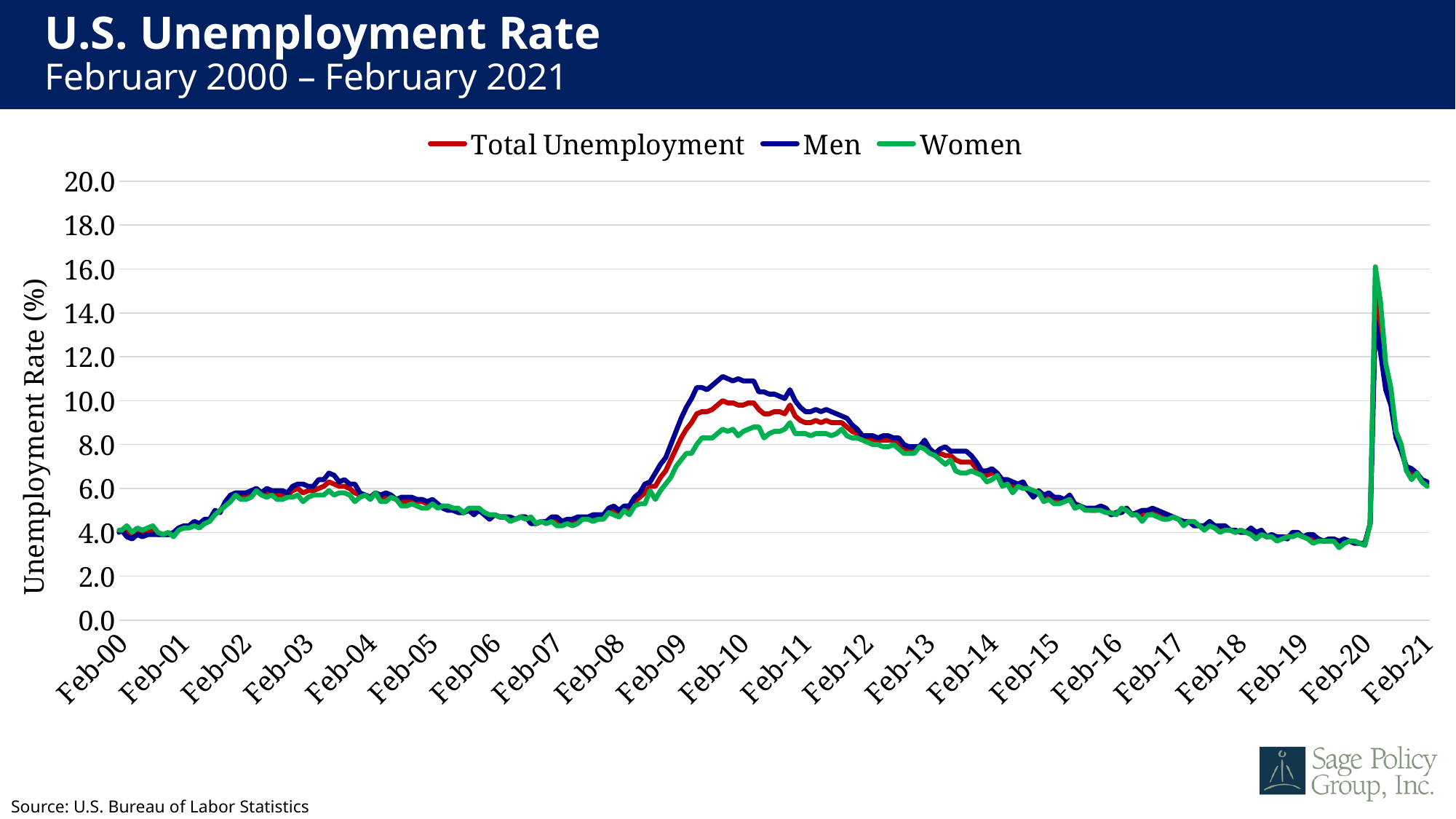
Is the peak value for Men around Feb-10 greater or less than 10.0? greater How many year labels are shown on the x axis? 22 Is the peak value for Women in 2020 greater or less than 14.0? greater How many series does the legend list? 3 Is the value for Total Unemployment at Feb-19 greater or less than 6.0? less What kind of chart is shown on the slide? line chart At the 2020 spike, which series reaches a higher peak, Men or Women? Women Do the unemployment rates rise or fall between Feb-10 and Feb-19? fall What is the title of the chart? U.S. Unemployment Rate Around Feb-10, which series is higher, Men or Women? Men Which series is drawn in green? Women